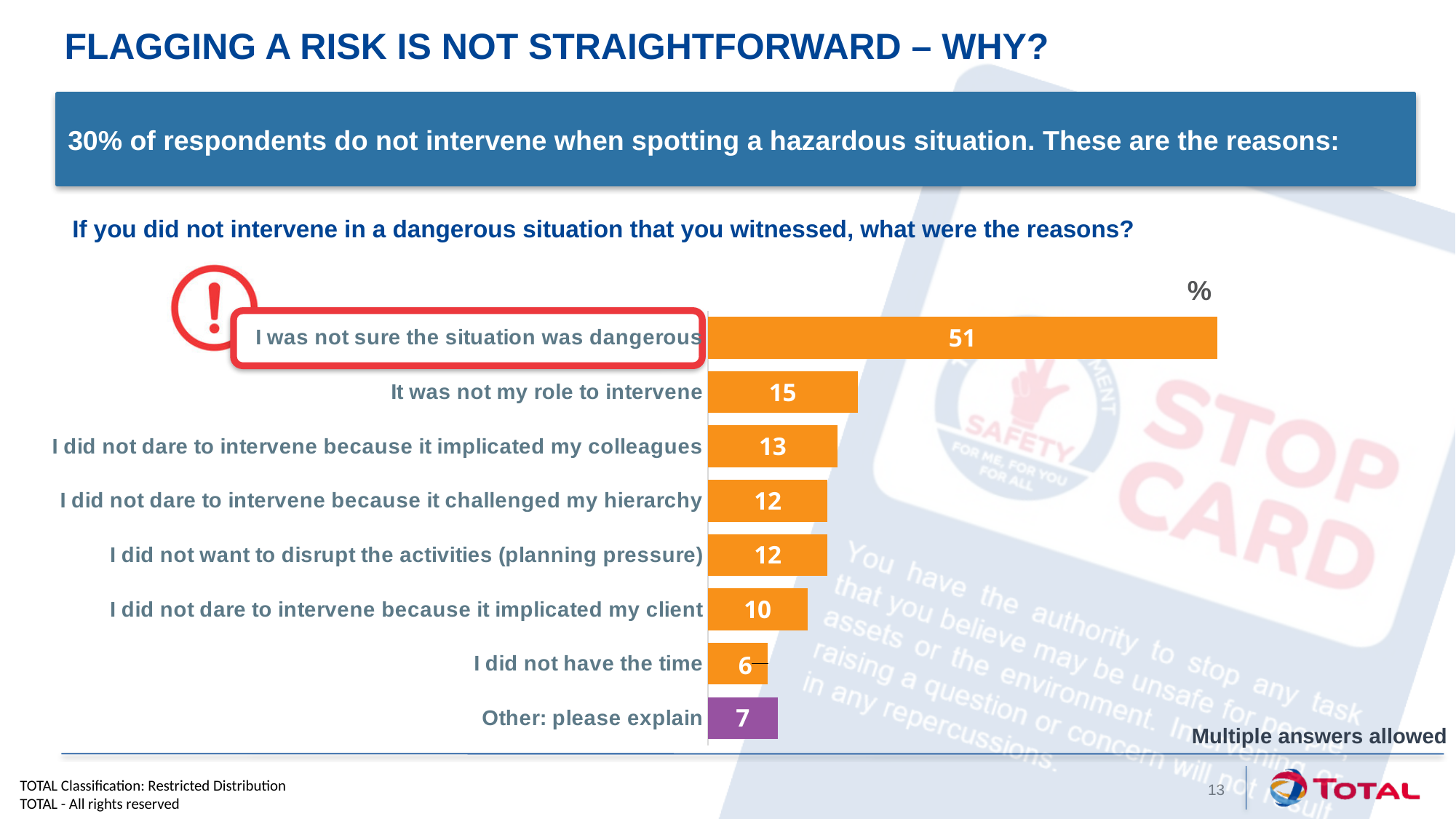
Which bar is shown in a different colour (purple) from the others? Other: please explain What is the value for "Other: please explain"? 7 What is the difference between "I was not sure the situation was dangerous" and "It was not my role to intervene"? 36 Which reason has the lowest value? I did not have the time Which reason has the highest value? I was not sure the situation was dangerous Which is larger: "I did not dare to intervene because it implicated my colleagues" or "I did not dare to intervene because it implicated my client"? I did not dare to intervene because it implicated my colleagues What is the difference between "I did not have the time" and "Other: please explain"? 1 What kind of chart is shown on the slide? Bar chart What is the value for "It was not my role to intervene"? 15 How many reasons (categories) are shown in the chart? 8 What is the value for "I was not sure the situation was dangerous"? 51 What is the value for "I did not dare to intervene because it implicated my client"? 10